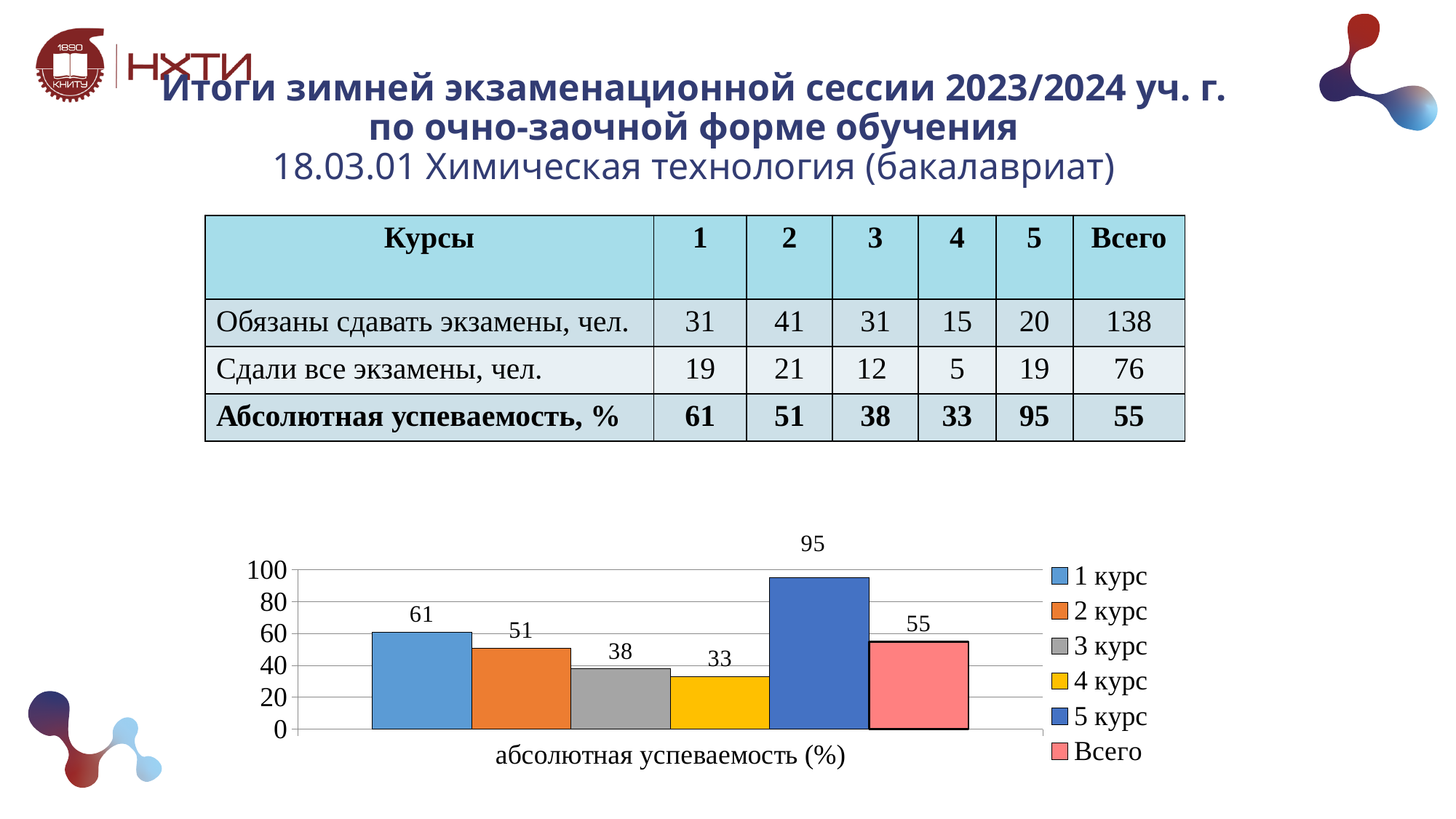
What is the value of the bar for 1 курс in the chart? 61 How many bars are plotted in the chart? 6 Which series has the lowest bar in the chart? 4 курс Which series has the highest bar in the chart? 5 курс What is the difference between the bars for 5 курс and 4 курс? 62 Which bar is larger, 2 курс or 3 курс? 2 курс What kind of chart is shown on the slide? bar chart Is the value for 3 курс greater or less than 40? less What is the value of the bar for 5 курс in the chart? 95 What is the label on the x axis of the chart? абсолютная успеваемость (%) What is the value of the bar for Всего in the chart? 55 How many series does the legend list? 6